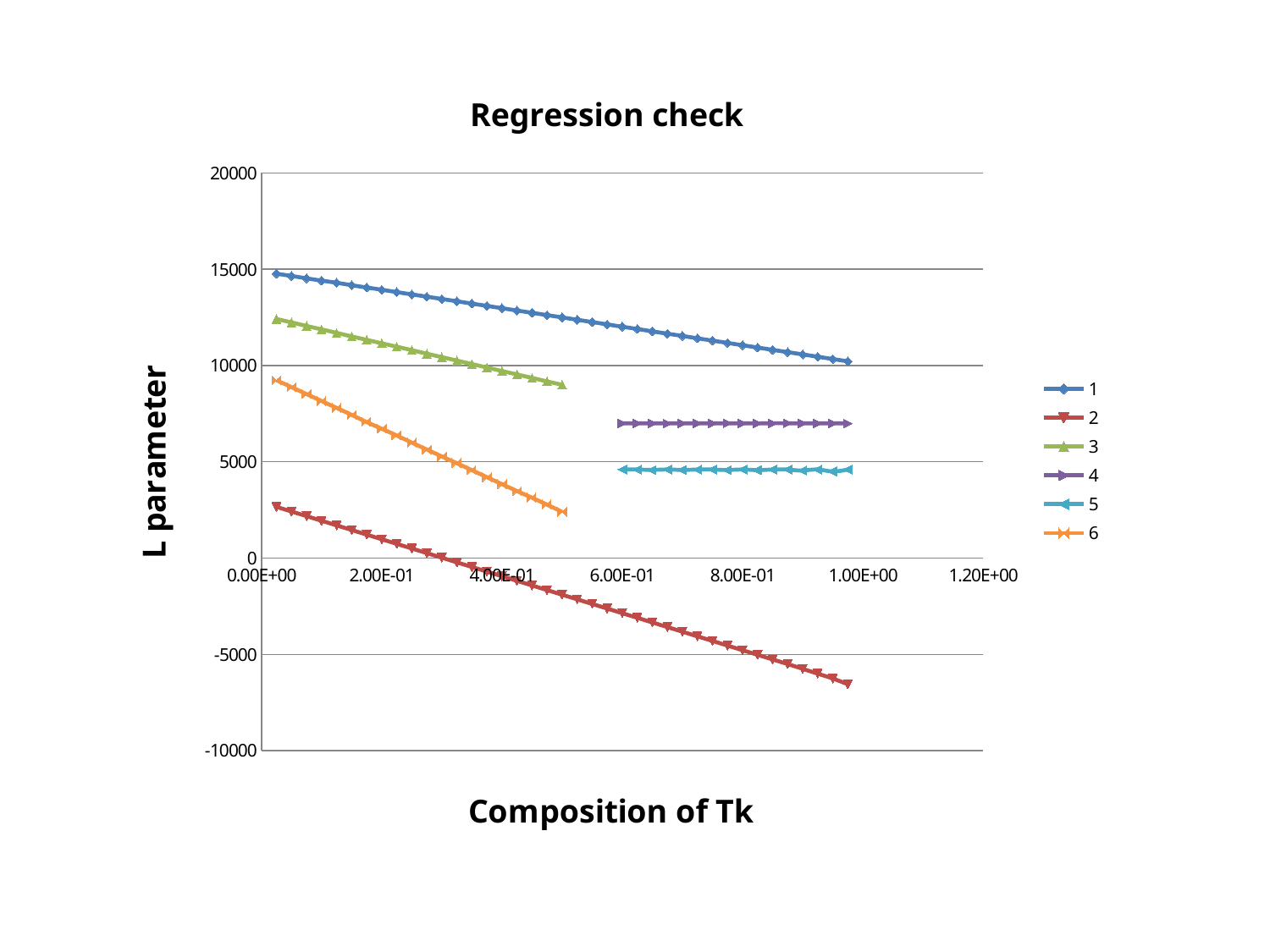
Which series reaches the lowest L parameter values on the chart? 2 How many series does the legend list? 6 Is the value for series 2 at Composition of Tk 1.00E+00 greater or less than -5000? less Is the value for series 4 at Composition of Tk 8.00E-01 greater or less than 5000? greater What is the label of the vertical axis? L parameter Is the value for series 1 at Composition of Tk 0.00E+00 greater or less than 10000? greater At Composition of Tk 8.00E-01, which series has the larger value, 4 or 5? 4 Do the values of series 1 rise or fall as Composition of Tk increases? fall What kind of chart is shown on the slide? line chart Which series reaches the highest L parameter values on the chart? 1 Do the values of series 2 rise or fall as Composition of Tk increases? fall What is the title of the chart? Regression check